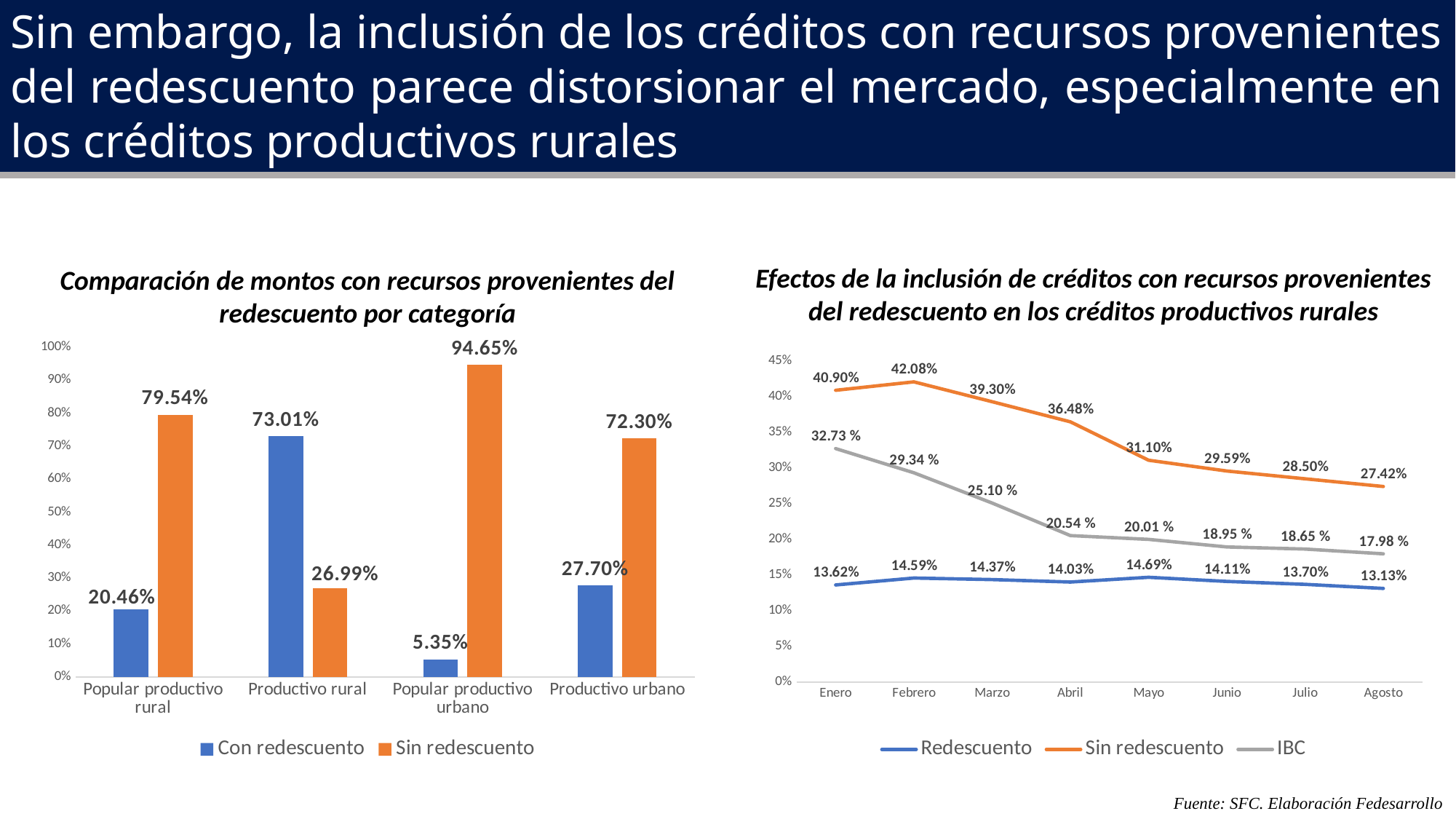
What kind of chart is the left chart 'Comparación de montos con recursos provenientes del redescuento por categoría'? Bar chart In the left chart 'Comparación de montos con recursos provenientes del redescuento por categoría', which category has the lowest 'Con redescuento' value? Popular productivo urbano In the right chart 'Efectos de la inclusión de créditos con recursos provenientes del redescuento en los créditos productivos rurales', does the 'IBC' series rise or fall from Enero to Agosto? Fall In the right chart 'Efectos de la inclusión de créditos con recursos provenientes del redescuento en los créditos productivos rurales', in which month is the 'Redescuento' value highest? Mayo In the right chart 'Efectos de la inclusión de créditos con recursos provenientes del redescuento en los créditos productivos rurales', what is the 'Sin redescuento' value for Abril? 36.48% In the left chart 'Comparación de montos con recursos provenientes del redescuento por categoría', how many categories are shown on the x axis? 4 In the right chart 'Efectos de la inclusión de créditos con recursos provenientes del redescuento en los créditos productivos rurales', what is the 'IBC' value for Agosto? 17.98 % In the left chart 'Comparación de montos con recursos provenientes del redescuento por categoría', what is the value of 'Con redescuento' for 'Productivo rural'? 73.01% In the right chart 'Efectos de la inclusión de créditos con recursos provenientes del redescuento en los créditos productivos rurales', how many series does the legend list? 3 In the left chart 'Comparación de montos con recursos provenientes del redescuento por categoría', what is the difference between 'Sin redescuento' and 'Con redescuento' for 'Popular productivo rural'? 59.08% In the left chart 'Comparación de montos con recursos provenientes del redescuento por categoría', what is the value of 'Sin redescuento' for 'Popular productivo urbano'? 94.65% In the right chart 'Efectos de la inclusión de créditos con recursos provenientes del redescuento en los créditos productivos rurales', which is larger in Febrero: 'Sin redescuento' or 'IBC'? Sin redescuento